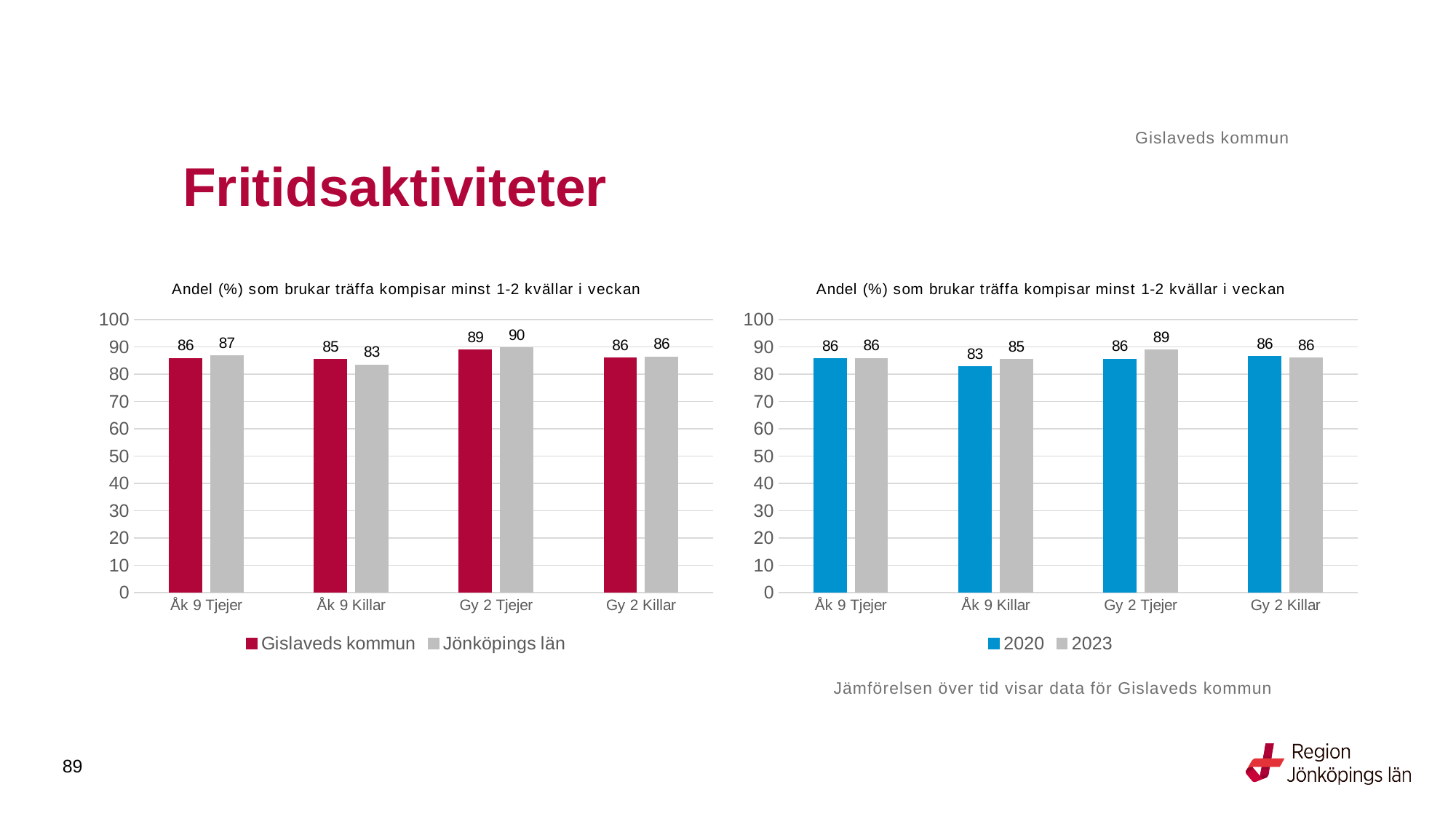
In the left chart, what is the difference between Gislaveds kommun and Jönköpings län for Åk 9 Killar? 2 In the left chart, what is the value for Jönköpings län for Åk 9 Killar? 83 In the right chart, what is the difference between 2023 and 2020 for Gy 2 Tjejer? 3 What type of chart is the right chart? Bar chart In the left chart, what is the value for Gislaveds kommun for Gy 2 Tjejer? 89 In the right chart, what is the value for 2020 for Åk 9 Killar? 83 How many categories are shown on the x axis of the right chart? 4 How many series does the legend of the left chart list? 2 In the left chart, which is larger for Gy 2 Tjejer: Gislaveds kommun or Jönköpings län? Jönköpings län In the right chart, what is the value for 2023 for Gy 2 Tjejer? 89 In the right chart, which category has the lowest value for 2020? Åk 9 Killar In the left chart, which category has the highest value for Jönköpings län? Gy 2 Tjejer